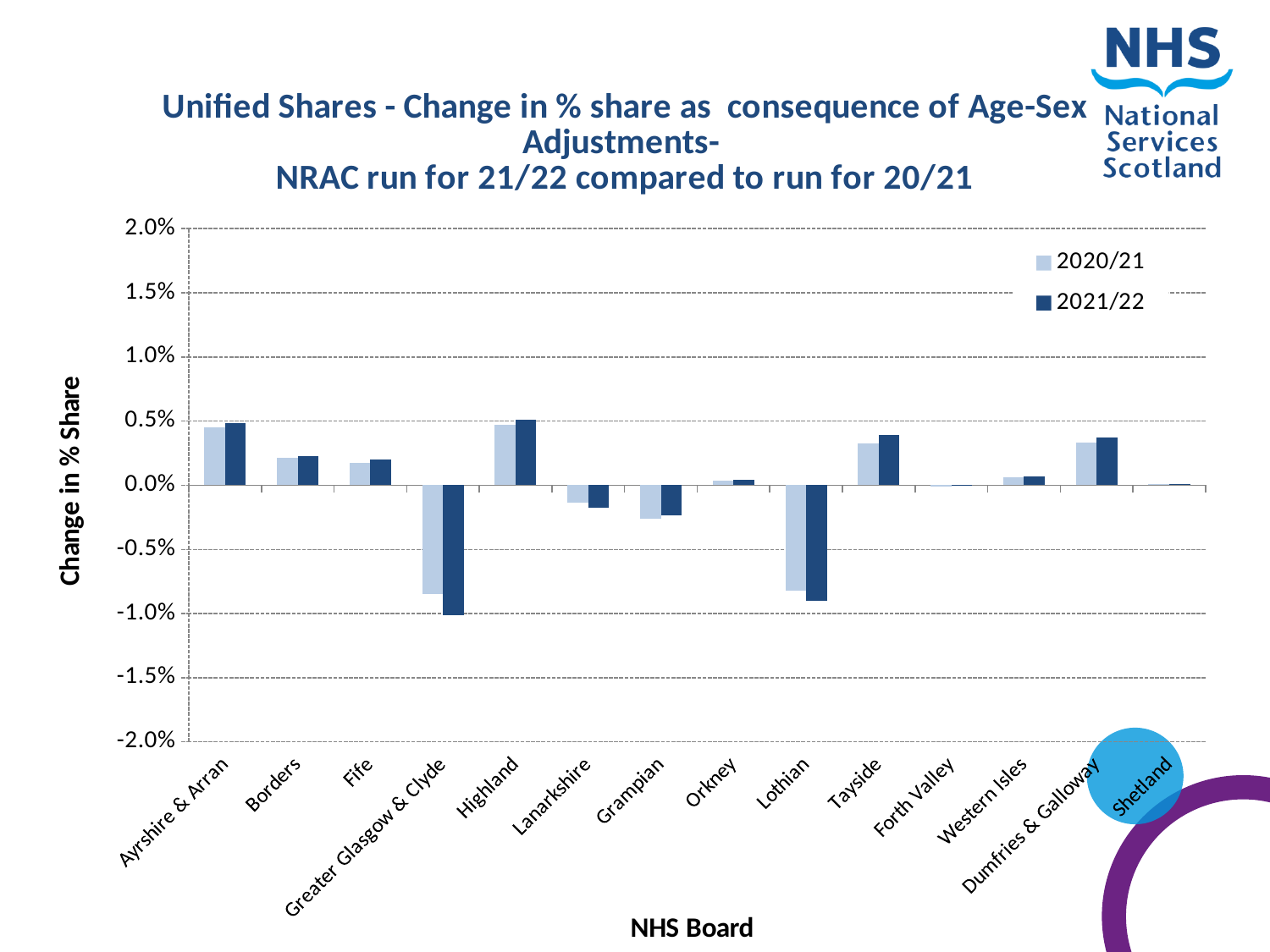
What kind of chart is shown on the slide? bar chart How many NHS Boards are shown on the x axis of the chart? 14 Which NHS Board has the lowest value for the 2021/22 series? Greater Glasgow & Clyde What is the label on the y axis of the chart? Change in % Share Is the 2021/22 value for Greater Glasgow & Clyde greater or less than -0.5%? less Which is larger, the 2021/22 value for Highland or the 2021/22 value for Grampian? Highland Is the 2021/22 value for Tayside greater or less than 0.5%? less Is the 2021/22 value for Highland greater or less than 0.0%? greater What are the two series named in the chart legend? 2020/21 and 2021/22 How many series does the chart legend list? 2 Which is larger, the 2021/22 value for Tayside or the 2021/22 value for Lanarkshire? Tayside